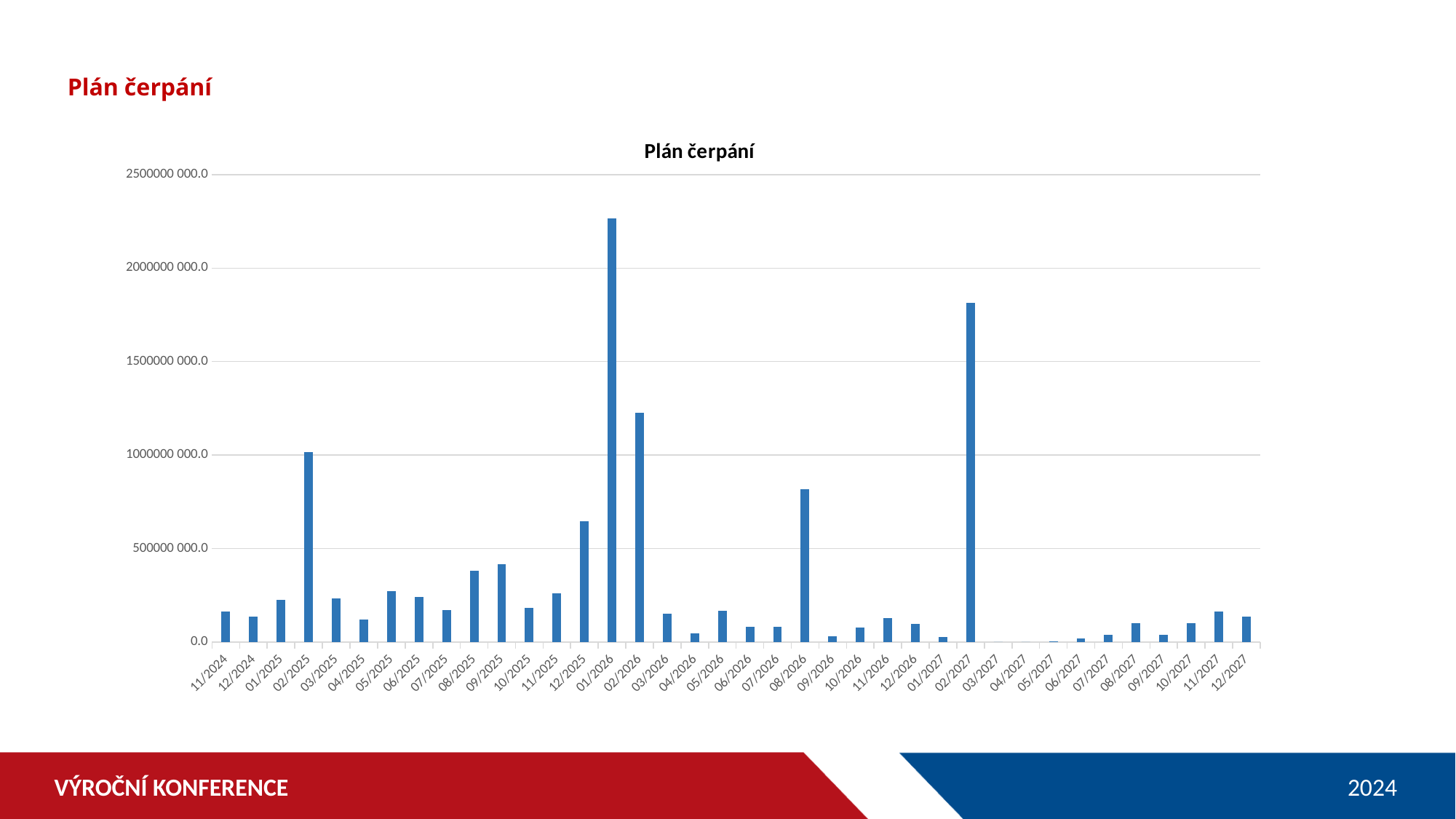
What kind of chart is shown on the slide? bar chart Is the value for 08/2026 greater or less than 1000000 000.0? less Which is larger, the value for 01/2026 or the value for 02/2027? 01/2026 How many months (categories) are plotted on the x axis? 38 Is the value for 01/2026 greater or less than 2000000 000.0? greater Is the value for 12/2025 greater or less than 500000 000.0? greater Which month has the highest value? 01/2026 What is the title of the chart? Plán čerpání Which is larger, the value for 02/2025 or the value for 02/2026? 02/2026